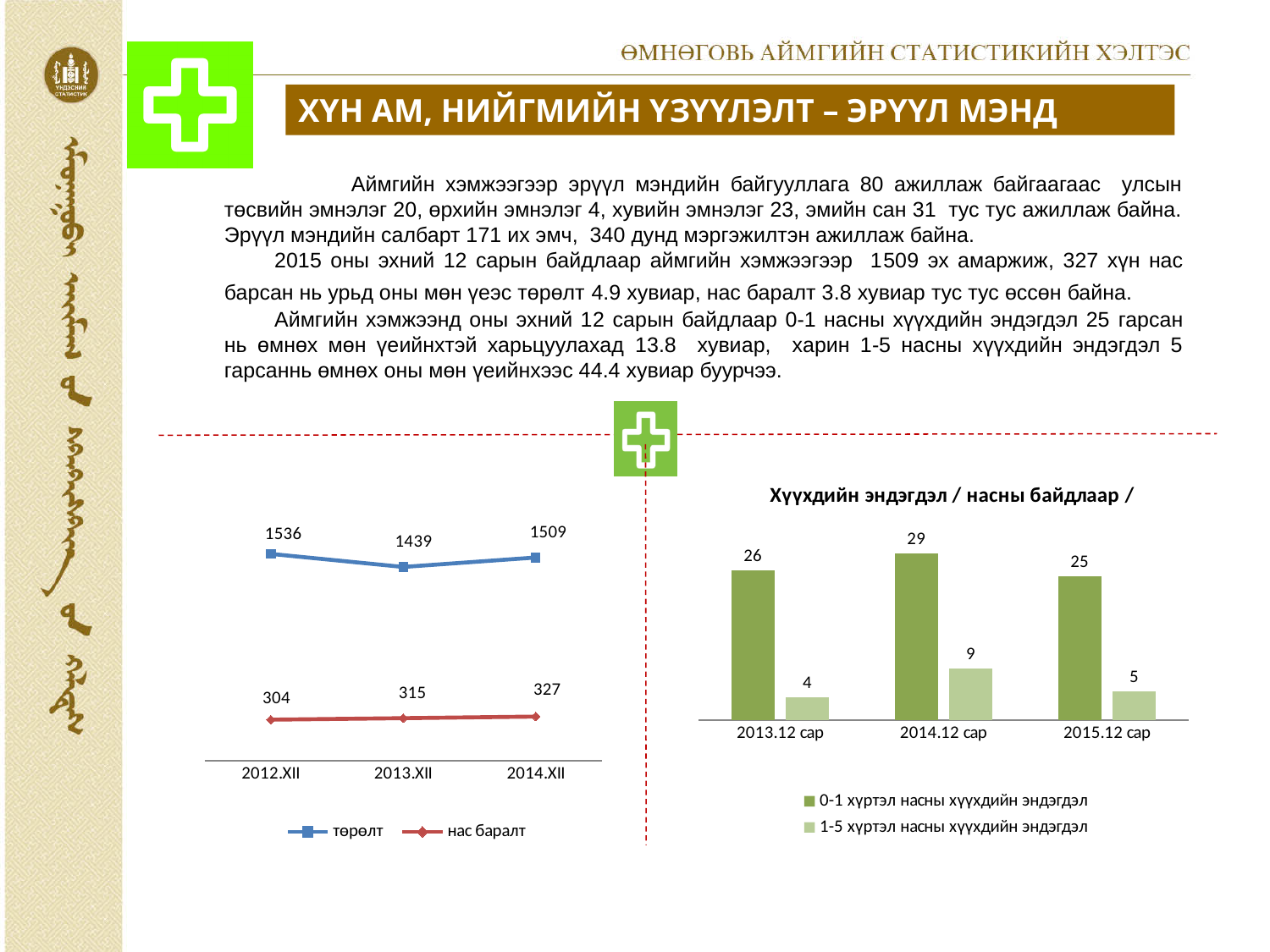
What kind of chart is the chart on the left of the slide? line chart In the line chart on the left of the slide, how many series does the legend list? 2 What kind of chart is the chart titled 'Хүүхдийн эндэгдэл / насны байдлаар /'? bar chart In the line chart on the left of the slide, what is the value of төрөлт for 2013.XII? 1439 In the chart titled 'Хүүхдийн эндэгдэл / насны байдлаар /', what is the difference between the 0-1 and 1-5 values for 2015.12 сар? 20 In the chart titled 'Хүүхдийн эндэгдэл / насны байдлаар /', which period has the lowest value for 0-1 хүртэл насны хүүхдийн эндэгдэл? 2015.12 сар In the line chart on the left of the slide, what is the value of нас баралт for 2014.XII? 327 In the line chart on the left of the slide, does нас баралт rise or fall from 2012.XII to 2014.XII? rise In the chart titled 'Хүүхдийн эндэгдэл / насны байдлаар /', what is the value of 0-1 хүртэл насны хүүхдийн эндэгдэл for 2014.12 сар? 29 In the chart titled 'Хүүхдийн эндэгдэл / насны байдлаар /', what is the value of 1-5 хүртэл насны хүүхдийн эндэгдэл for 2013.12 сар? 4 In the line chart on the left of the slide, what is the difference between the төрөлт values for 2012.XII and 2013.XII? 97 In the line chart on the left of the slide, which period has the highest төрөлт value? 2012.XII